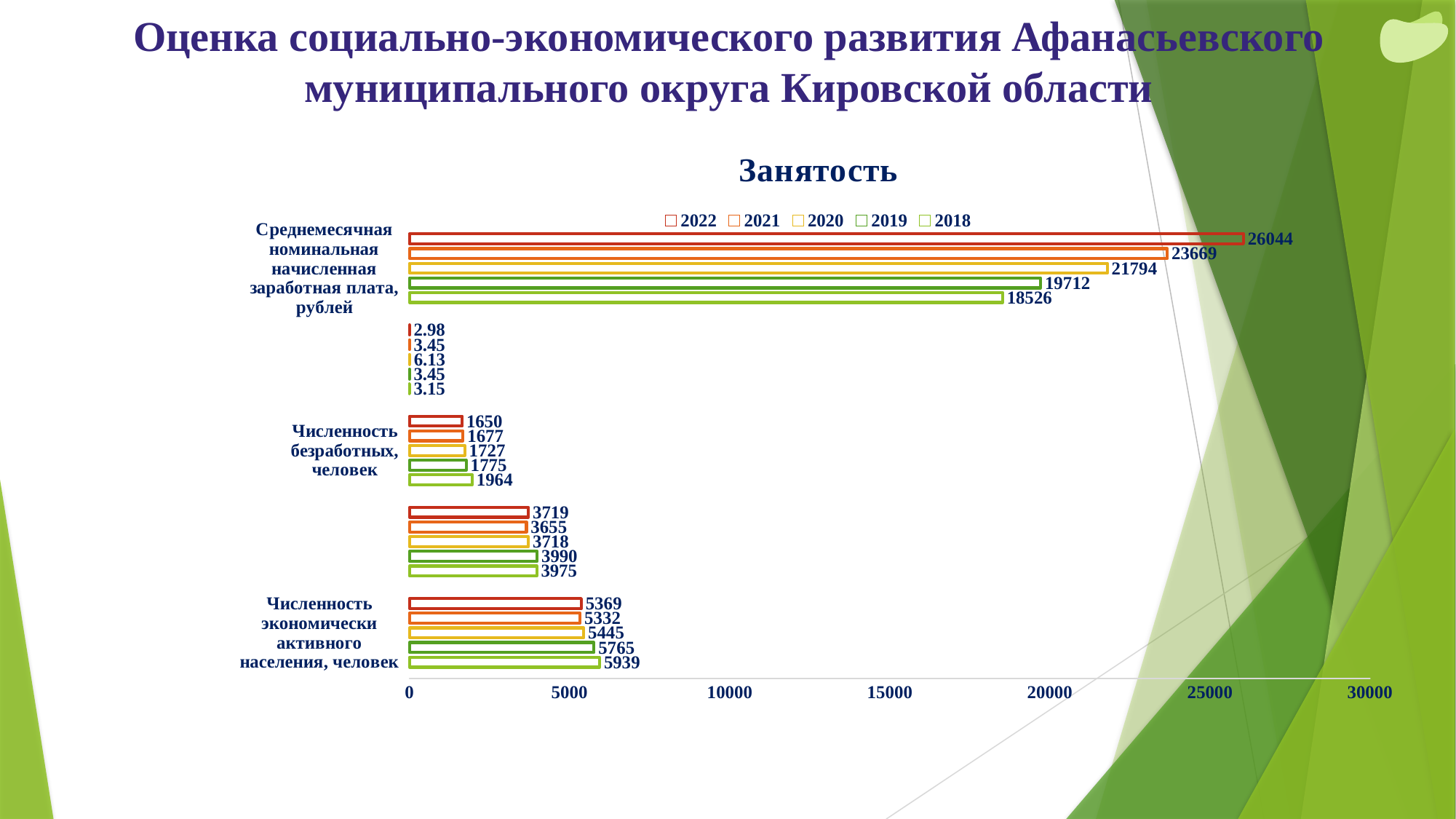
In the "Занятость" chart, is the 2021 value for "Среднемесячная номинальная начисленная заработная плата, рублей" greater or less than 20000? greater In the "Занятость" chart, which year has the lowest value for "Численность безработных, человек"? 2022 In the "Занятость" chart, which is larger for "Численность безработных, человек": the 2019 value or the 2020 value? 2019 In the "Занятость" chart, what is the value for 2018 in the category "Численность безработных, человек"? 1964 How many series does the legend of the "Занятость" chart list? 5 In the "Занятость" chart, which year has the highest value for "Среднемесячная номинальная начисленная заработная плата, рублей"? 2022 In the "Занятость" chart, what is the value for 2022 in the category "Среднемесячная номинальная начисленная заработная плата, рублей"? 26044 In the "Занятость" chart, do the values for "Среднемесячная номинальная начисленная заработная плата, рублей" rise or fall from 2018 to 2022? rise In the "Занятость" chart, what is the difference between the 2022 and 2018 values for "Среднемесячная номинальная начисленная заработная плата, рублей"? 7518 In the "Занятость" chart, what is the difference between the 2018 and 2022 values for "Численность экономически активного населения, человек"? 570 In the "Занятость" chart, what is the value for 2020 in the category "Численность экономически активного населения, человек"? 5445 What kind of chart is shown under the title "Занятость"? bar chart